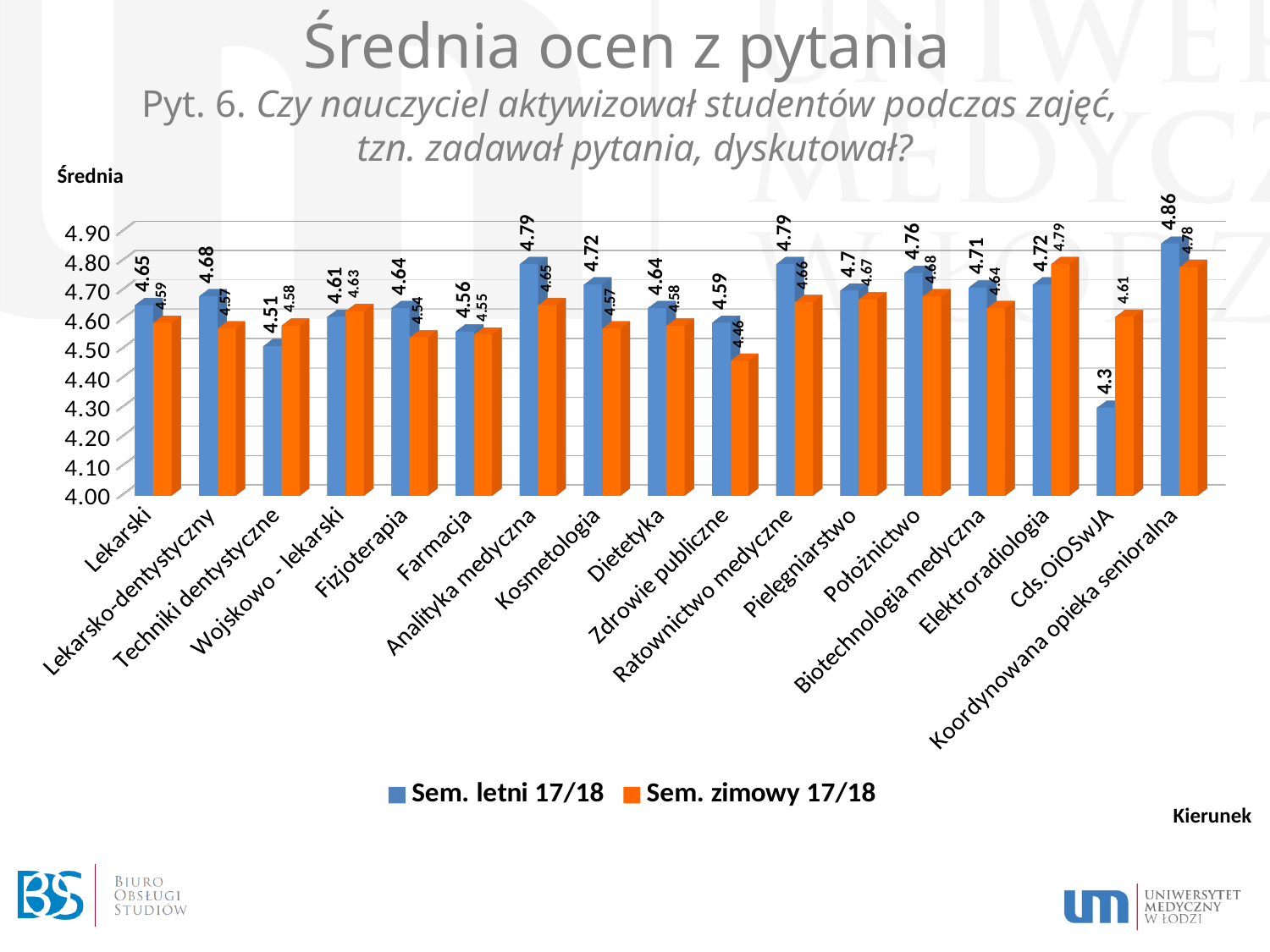
Which category has the lowest Sem. zimowy 17/18 value? Zdrowie publiczne Which category has the highest Sem. letni 17/18 value? Koordynowana opieka senioralna What kind of chart is shown on the slide? bar chart For Elektroradiologia, which series has the larger value: Sem. letni 17/18 or Sem. zimowy 17/18? Sem. zimowy 17/18 What is the Sem. letni 17/18 value for Cds.OiOSwJA? 4.3 Is the Sem. letni 17/18 value for Cds.OiOSwJA greater or less than 4.40? less What is the difference between the Sem. zimowy 17/18 and Sem. letni 17/18 values for Cds.OiOSwJA? 0.31 How many categories (kierunki) are shown on the x axis? 17 Which category has the lowest Sem. letni 17/18 value? Cds.OiOSwJA How many series does the legend list? 2 What is the Sem. letni 17/18 value for Koordynowana opieka senioralna? 4.86 What is the Sem. zimowy 17/18 value for Zdrowie publiczne? 4.46